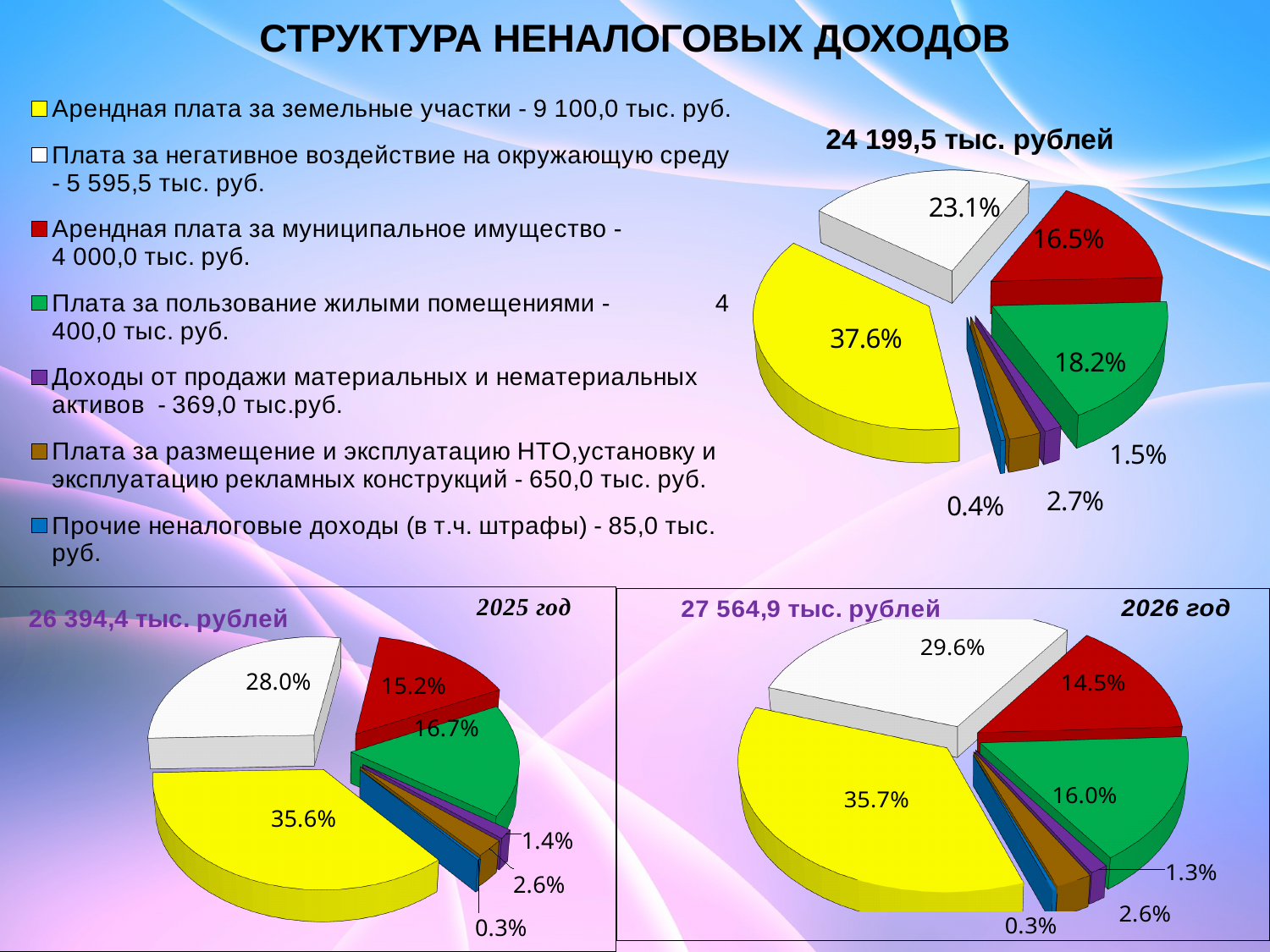
In the 2026 год pie chart, which is larger: the green slice (Плата за пользование жилыми помещениями) or the red slice (Арендная плата за муниципальное имущество)? Плата за пользование жилыми помещениями In the top-right pie chart (24 199,5 тыс. рублей), which category has the smallest slice? Прочие неналоговые доходы (в т.ч. штрафы) In the top-right pie chart (24 199,5 тыс. рублей), what share is shown for the white slice, Плата за негативное воздействие на окружающую среду? 23.1% In the top-right pie chart (24 199,5 тыс. рублей), what share is shown for the yellow slice, Арендная плата за земельные участки? 37.6% In the 2026 год pie chart, what is the difference between the yellow slice (35.7%) and the white slice (29.6%)? 6.1% What total amount is shown above the 2026 год pie chart? 27 564,9 тыс. рублей In the 2025 год pie chart, what share is shown for the green slice, Плата за пользование жилыми помещениями? 16.7% What type of chart is used for the 2025 год chart? Pie chart How many categories does the legend on the slide list? 7 In the top-right pie chart (24 199,5 тыс. рублей), which category has the largest slice? Арендная плата за земельные участки